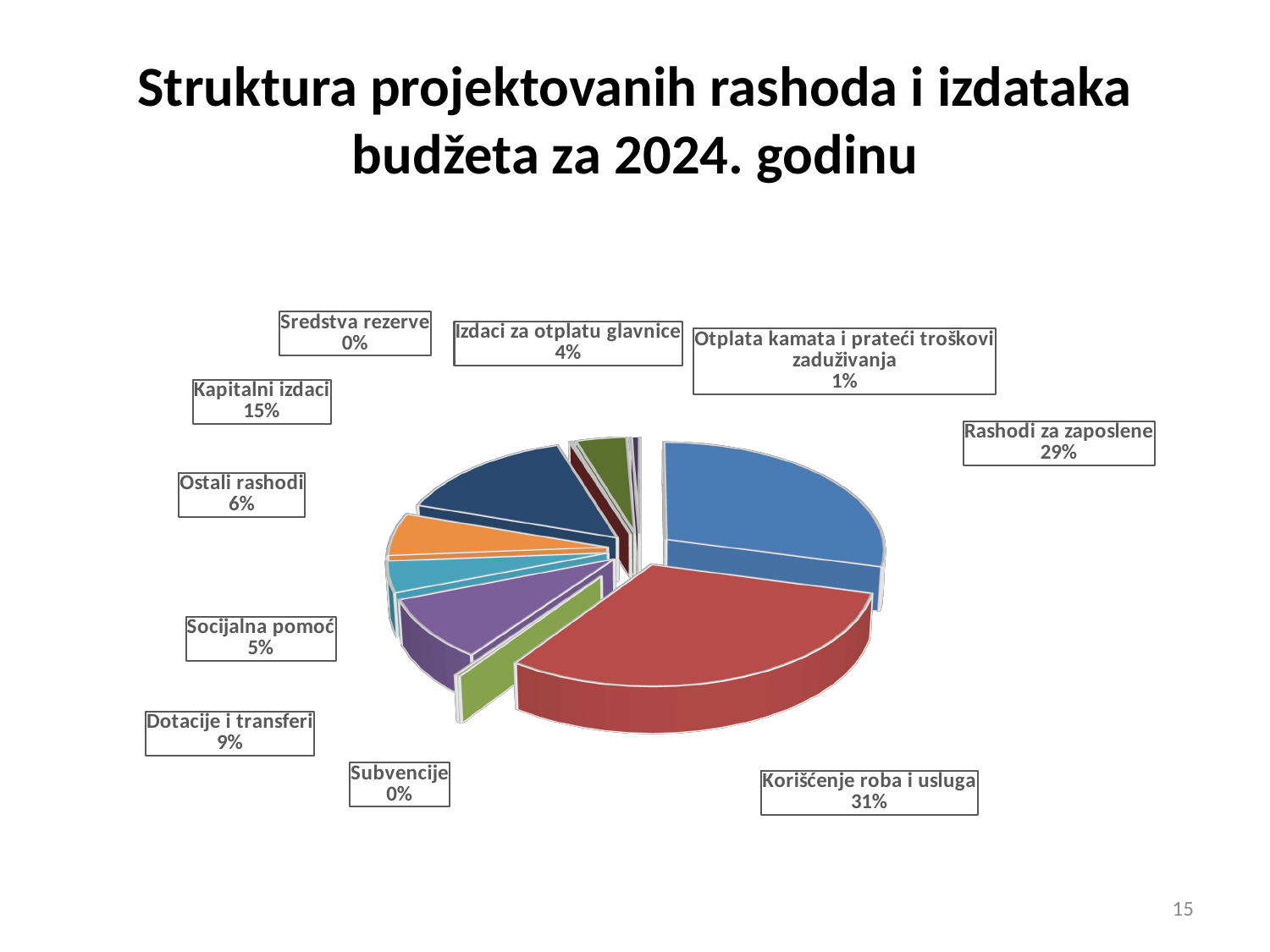
Which category has the largest share of the pie? Korišćenje roba i usluga What kind of chart is shown on the slide? pie chart What is the difference in percentage points between Korišćenje roba i usluga and Rashodi za zaposlene? 2 What share of the pie does Rashodi za zaposlene have? 29% What is the value shown for Dotacije i transferi? 9% What share of the pie does Korišćenje roba i usluga have? 31% What is the title of the slide? Struktura projektovanih rashoda i izdataka budžeta za 2024. godinu What is the value shown for Otplata kamata i prateći troškovi zaduživanja? 1% How many categories are labelled on the pie chart? 10 What is the difference in percentage points between Kapitalni izdaci and Izdaci za otplatu glavnice? 11 Which is larger, Ostali rashodi or Socijalna pomoć? Ostali rashodi What is the value shown for Kapitalni izdaci? 15%